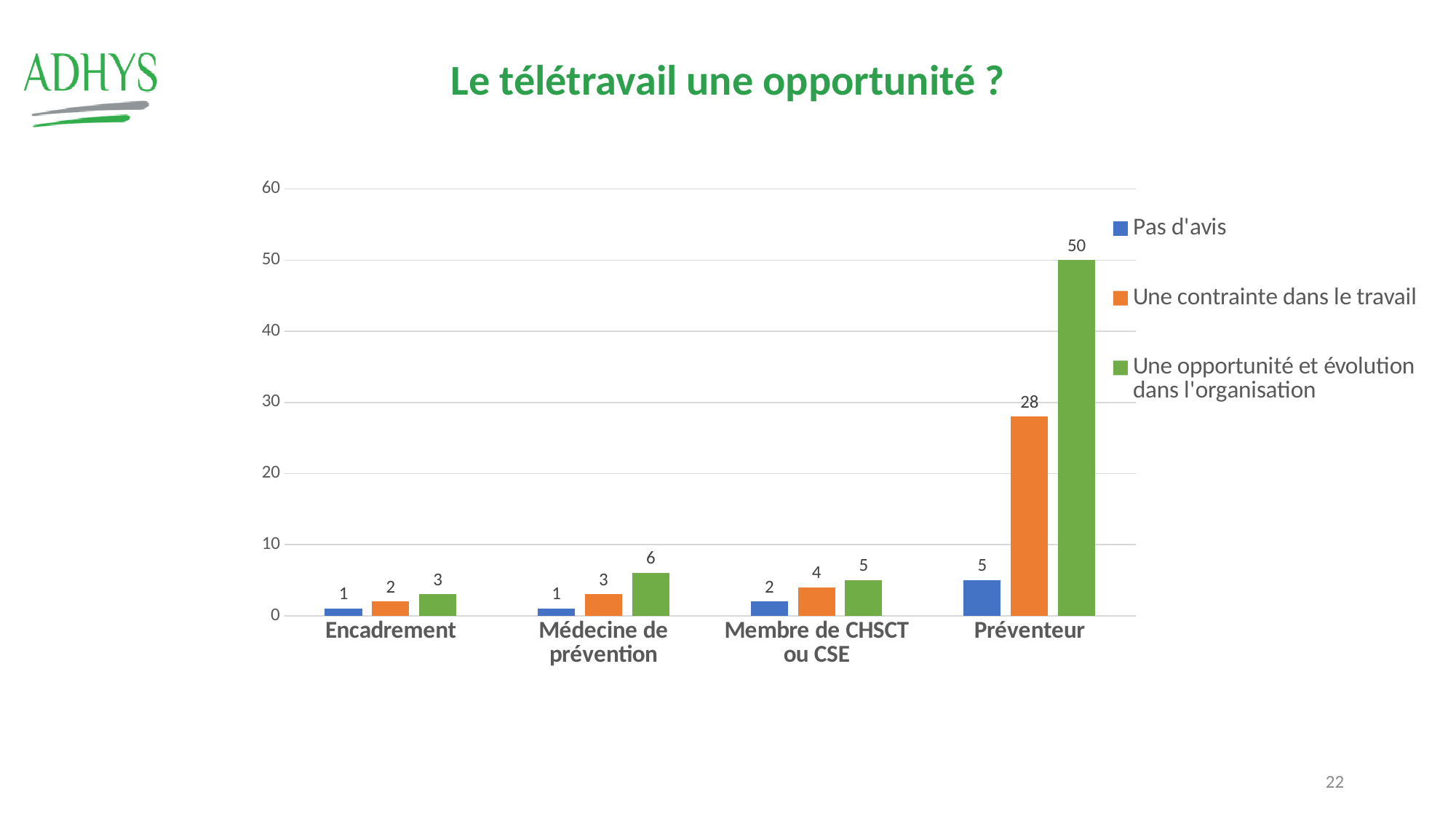
Is the value for "Une contrainte dans le travail" for Préventeur greater or less than 20? greater What is the value for "Une opportunité et évolution dans l'organisation" for Médecine de prévention? 6 What is the value for "Pas d'avis" for Membre de CHSCT ou CSE? 2 How many categories are shown on the x axis? 4 Which category has the highest value for "Une contrainte dans le travail"? Préventeur What is the difference between the "Une opportunité et évolution dans l'organisation" and "Une contrainte dans le travail" values for Préventeur? 22 How many series does the legend list? 3 Which is larger for Membre de CHSCT ou CSE: "Une contrainte dans le travail" or "Une opportunité et évolution dans l'organisation"? Une opportunité et évolution dans l'organisation Which category has the lowest value for "Une opportunité et évolution dans l'organisation"? Encadrement What is the value for "Une opportunité et évolution dans l'organisation" for Préventeur? 50 What is the value for "Une contrainte dans le travail" for Préventeur? 28 What kind of chart is shown on the slide? bar chart